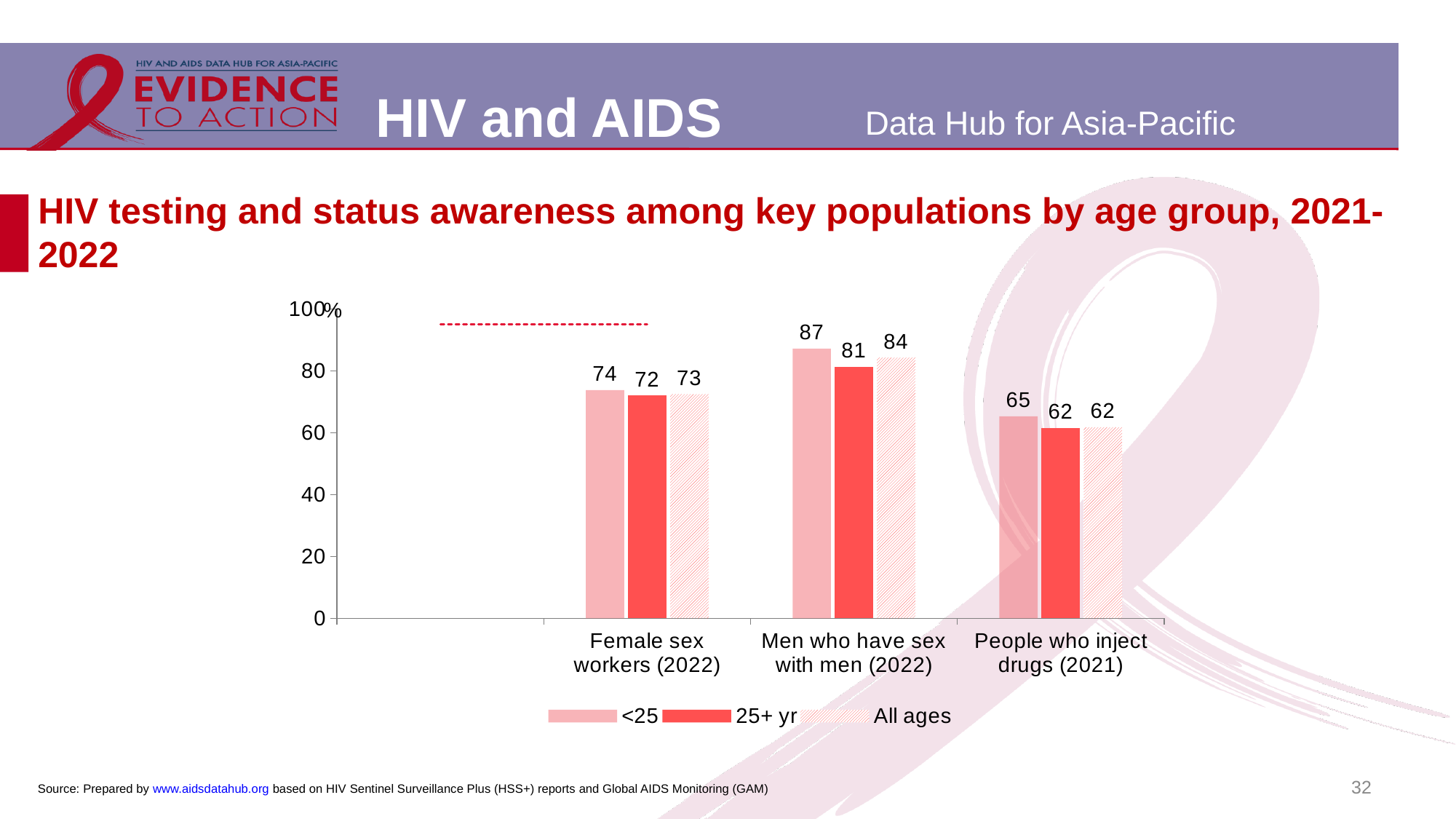
Which is larger for female sex workers (2022): the <25 value or the All ages value? <25 How many series does the legend list? 3 Is the 25+ yr value for people who inject drugs (2021) greater or less than 80? less What is the maximum value shown on the y axis? 100% What is the difference between the <25 and 25+ yr values for men who have sex with men (2022)? 6 What is the value for the 25+ yr age group among men who have sex with men (2022)? 81 What kind of chart is shown on the slide? Bar chart How many key population categories are shown on the x axis? 3 What is the value for the <25 age group among female sex workers (2022)? 74 Which key population has the highest value for the <25 age group? Men who have sex with men (2022) What is the All ages value for people who inject drugs (2021)? 62 Which key population has the lowest All ages value? People who inject drugs (2021)